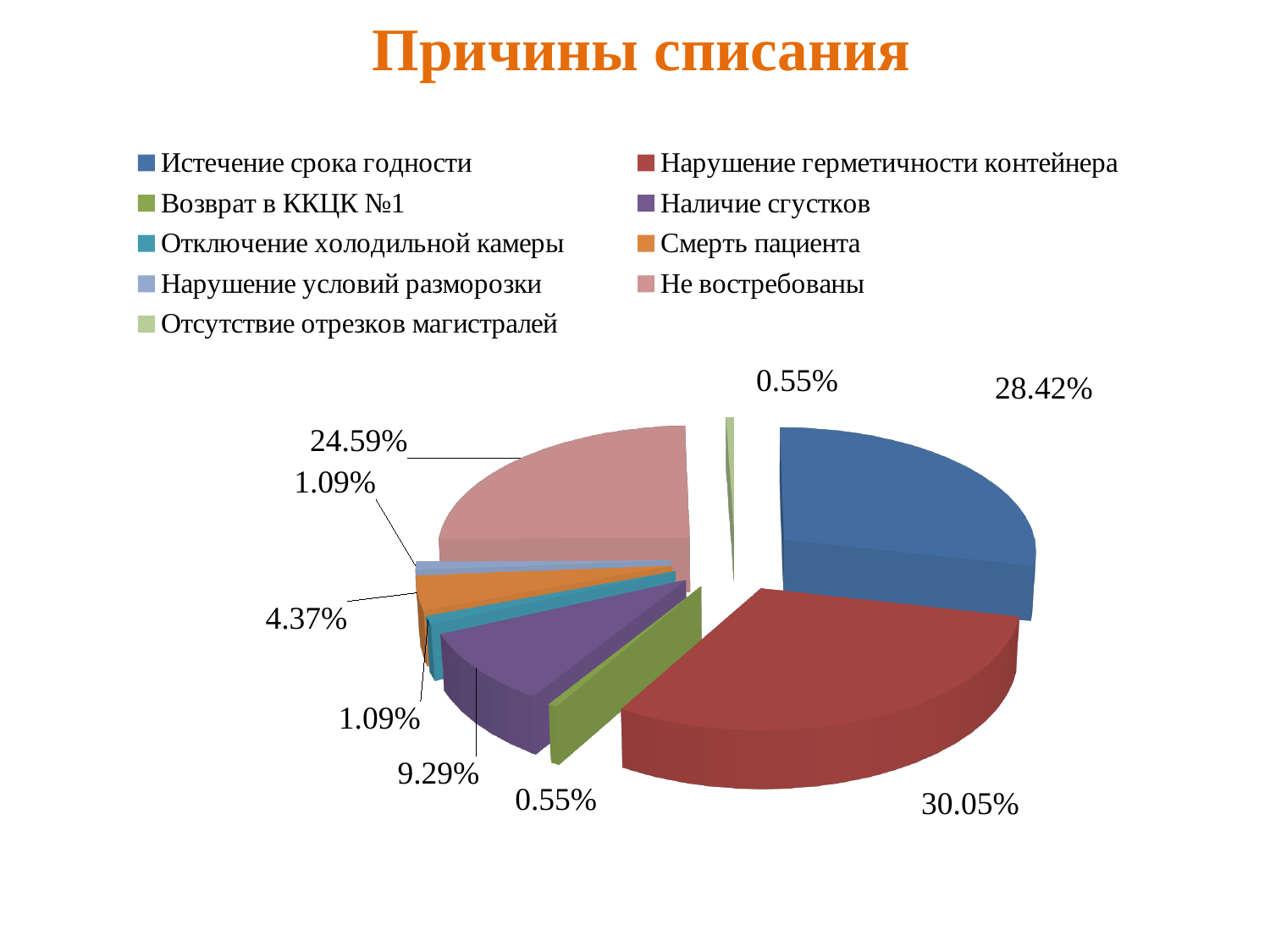
How many categories does the legend list? 9 What share of the pie is 'Не востребованы'? 24.59% Which category has the largest share of the pie? Нарушение герметичности контейнера What is the value for 'Наличие сгустков'? 9.29% What is the title of the chart? Причины списания Which is larger, 'Истечение срока годности' or 'Не востребованы'? Истечение срока годности What share of the pie is 'Нарушение герметичности контейнера'? 30.05% What colour is the slice for 'Не востребованы'? pink What share of the pie is 'Истечение срока годности'? 28.42% What kind of chart is shown on the slide? pie chart What is the value for 'Смерть пациента'? 4.37% What is the difference between 'Нарушение герметичности контейнера' and 'Истечение срока годности'? 1.63%